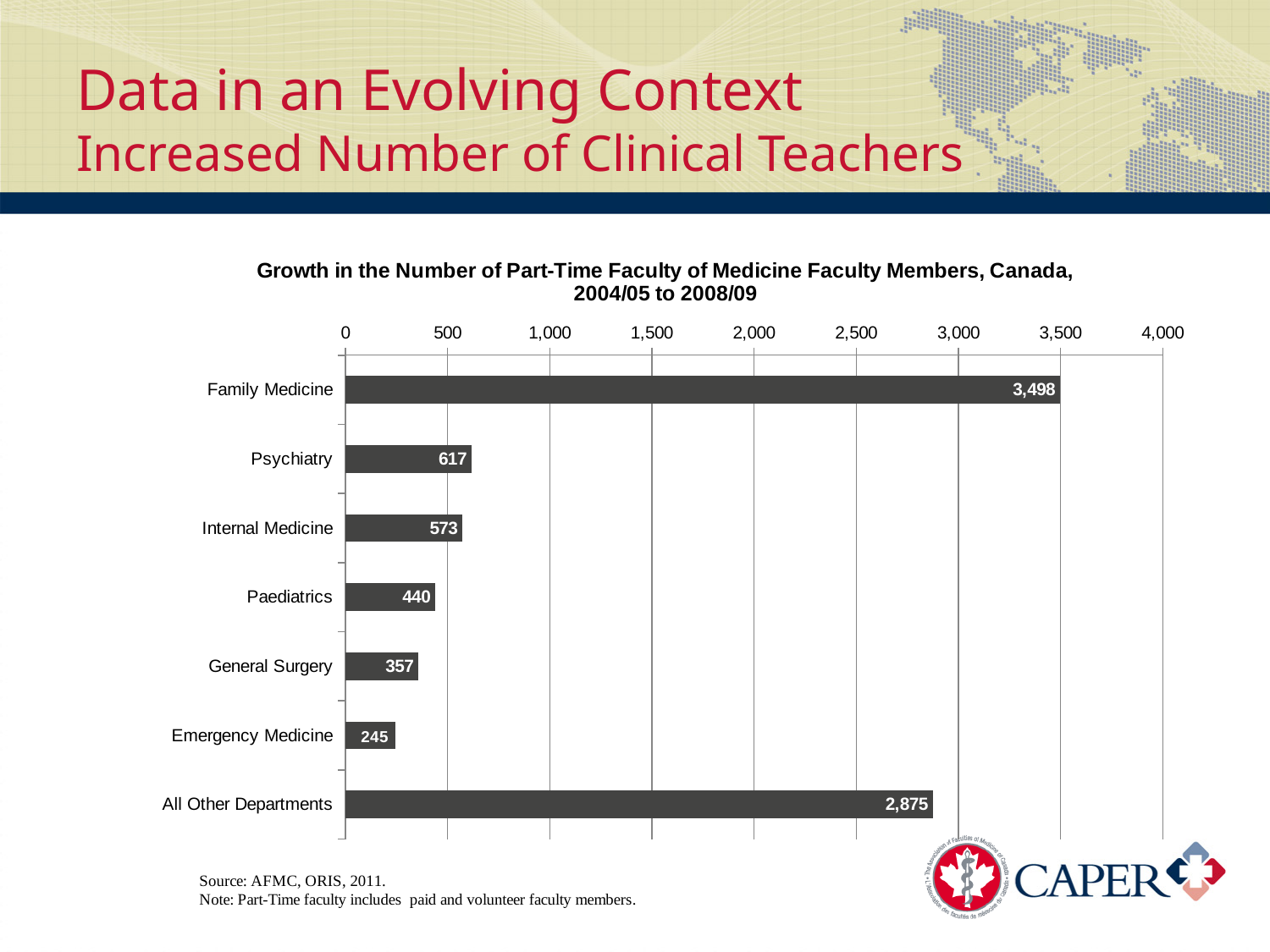
What is the value for All Other Departments? 2,875 What is the title of the chart? Growth in the Number of Part-Time Faculty of Medicine Faculty Members, Canada, 2004/05 to 2008/09 Which category has the lowest value? Emergency Medicine Which category has the highest value? Family Medicine How many categories are shown in the chart? 7 Which is larger, the value for Paediatrics or the value for General Surgery? Paediatrics What kind of chart is shown on the slide? Bar chart What is the difference between the values for Psychiatry and Internal Medicine? 44 What is the difference between the values for Family Medicine and All Other Departments? 623 What is the value for Psychiatry? 617 What is the value for Family Medicine? 3,498 What is the value for Emergency Medicine? 245